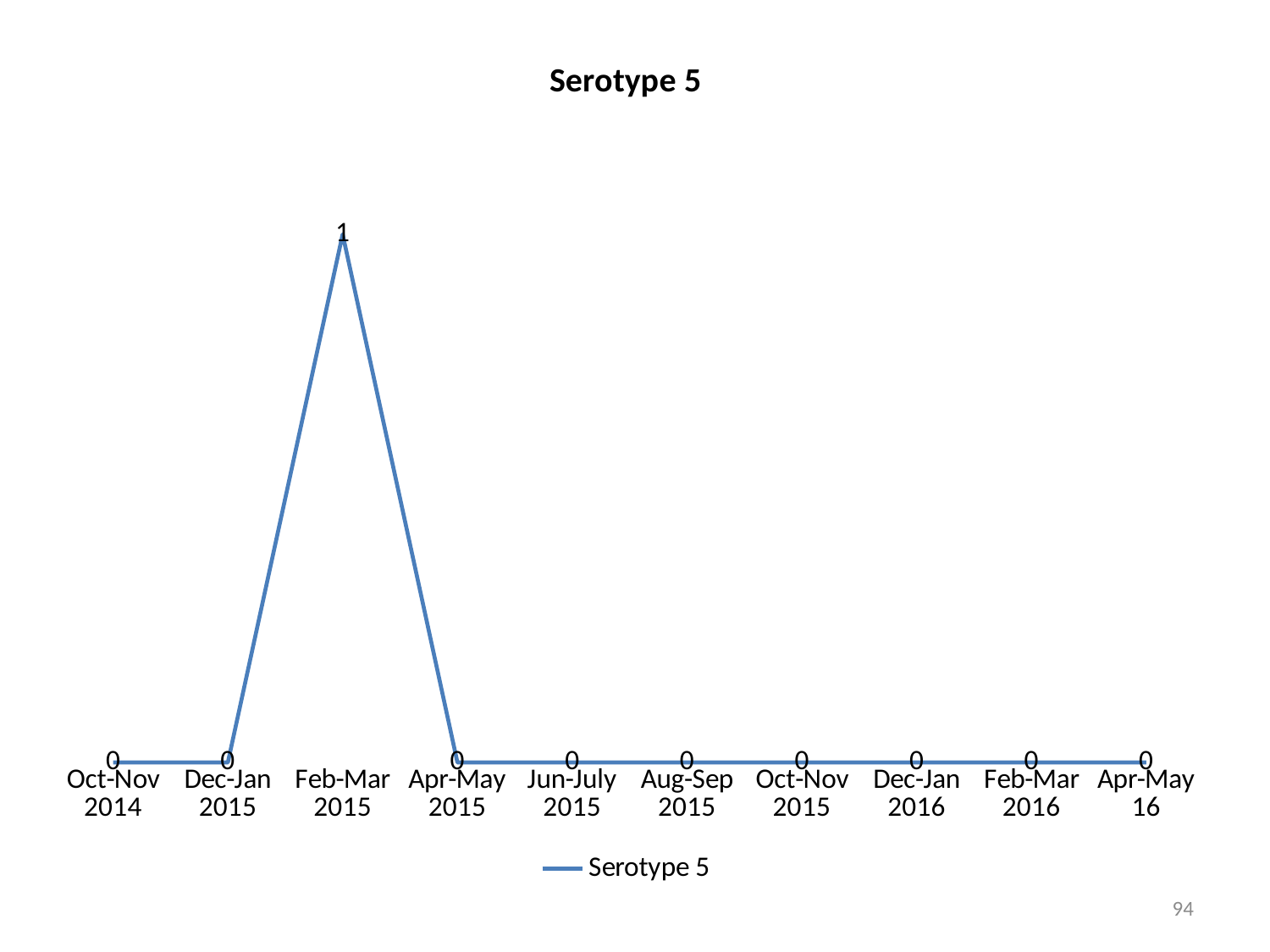
What is the name of the series shown in the legend? Serotype 5 What is the value for Feb-Mar 2015? 1 What is the value for Apr-May 16? 0 What is the value for Oct-Nov 2014? 0 What kind of chart is shown on the slide? line chart How many series does the legend list? 1 Which is larger, the value for Feb-Mar 2015 or the value for Dec-Jan 2015? Feb-Mar 2015 What is the title of the chart? Serotype 5 What is the value for Aug-Sep 2015? 0 How many data points are plotted on the chart? 10 What is the difference between the values for Feb-Mar 2015 and Apr-May 2015? 1 Which period has the highest value? Feb-Mar 2015